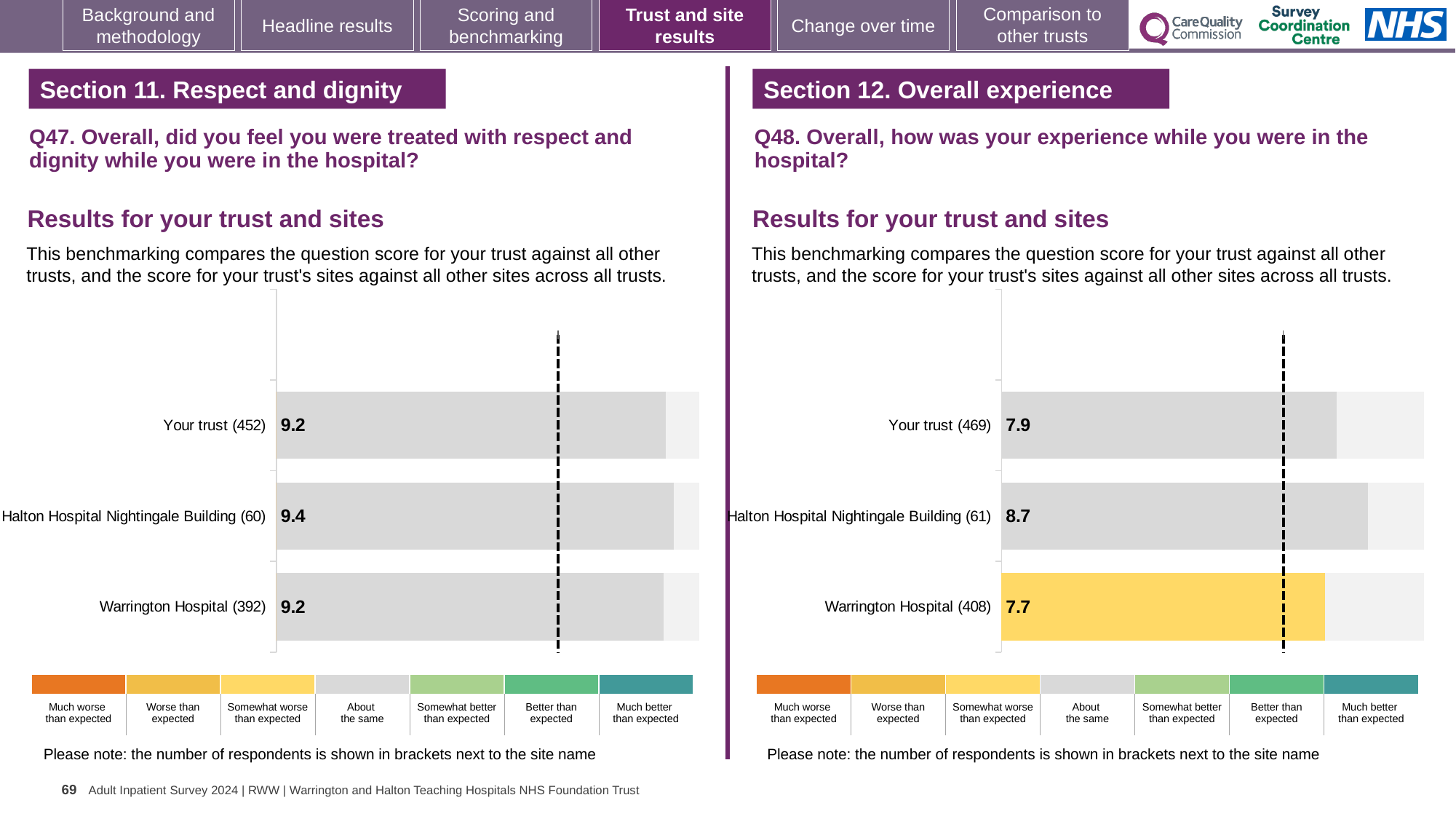
On the Q48 chart (right), what is the score for Halton Hospital Nightingale Building? 8.7 How many bars are plotted on the Q47 chart (left)? 3 On the Q48 chart (right), which is larger: the score for Your trust or the score for Warrington Hospital? Your trust On the Q48 chart (right), which site or trust has the lowest score? Warrington Hospital On the Q48 chart (right), which benchmark category does the colour of the Warrington Hospital bar indicate? Somewhat worse than expected On the Q47 chart (left), what is the score for Your trust? 9.2 On the Q47 chart (left), what is the score for Halton Hospital Nightingale Building? 9.4 On the Q47 chart (left), which has the highest score? Halton Hospital Nightingale Building On the Q48 chart (right), which site or trust has the highest score? Halton Hospital Nightingale Building On the Q48 chart (right), what is the score for Warrington Hospital? 7.7 On the Q48 chart (right), what is the difference between the scores for Halton Hospital Nightingale Building and Warrington Hospital? 1.0 On the Q47 chart (left), what is the difference between the scores for Halton Hospital Nightingale Building and Your trust? 0.2